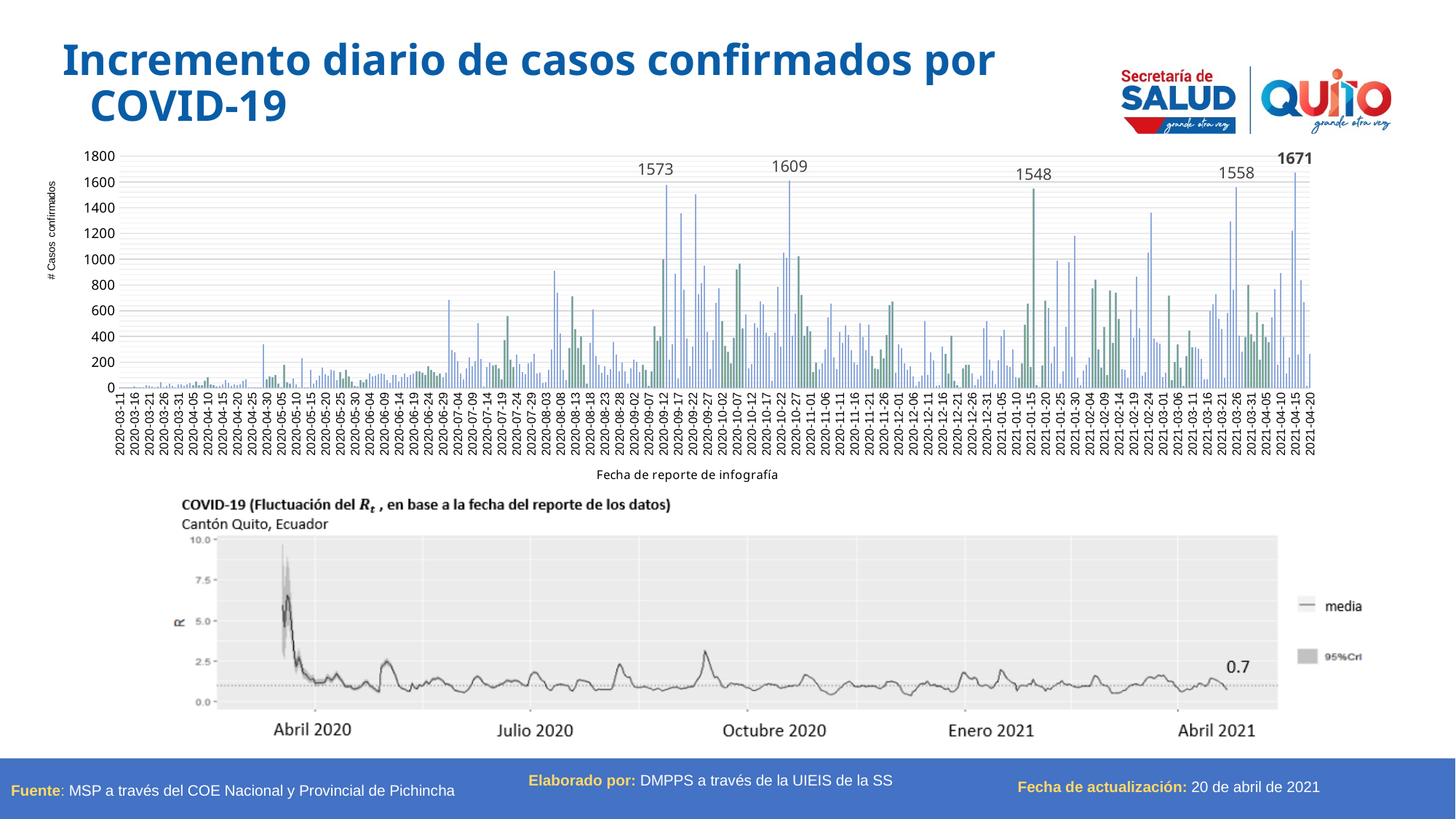
In the top chart of daily confirmed cases, which labeled peak is larger, 1573 or 1558? 1573 In the top chart of daily confirmed cases, what is the lowest of the five labeled peak values? 1548 In the top chart of daily confirmed cases, what is the highest value shown on the vertical axis? 1800 In the bottom Rt chart, what is the value labeled at the end of the line near Abril 2021? 0.7 What kind of chart is the top chart showing daily confirmed COVID-19 cases? bar chart How many entries does the legend of the bottom Rt chart list? 2 In the bottom Rt chart, is the peak value in Abril 2020 greater or less than 5.0? greater In the top chart of daily confirmed cases, what is the highest value labeled on the chart? 1671 In the top chart of daily confirmed cases, what is the difference between the labeled peaks 1609 and 1573? 36 What kind of chart is the bottom chart showing the fluctuation of Rt? line chart In the top chart of daily confirmed cases, what is the difference between the labeled peaks 1671 and 1609? 62 What is the vertical axis label of the top chart of daily confirmed cases? # Casos confirmados